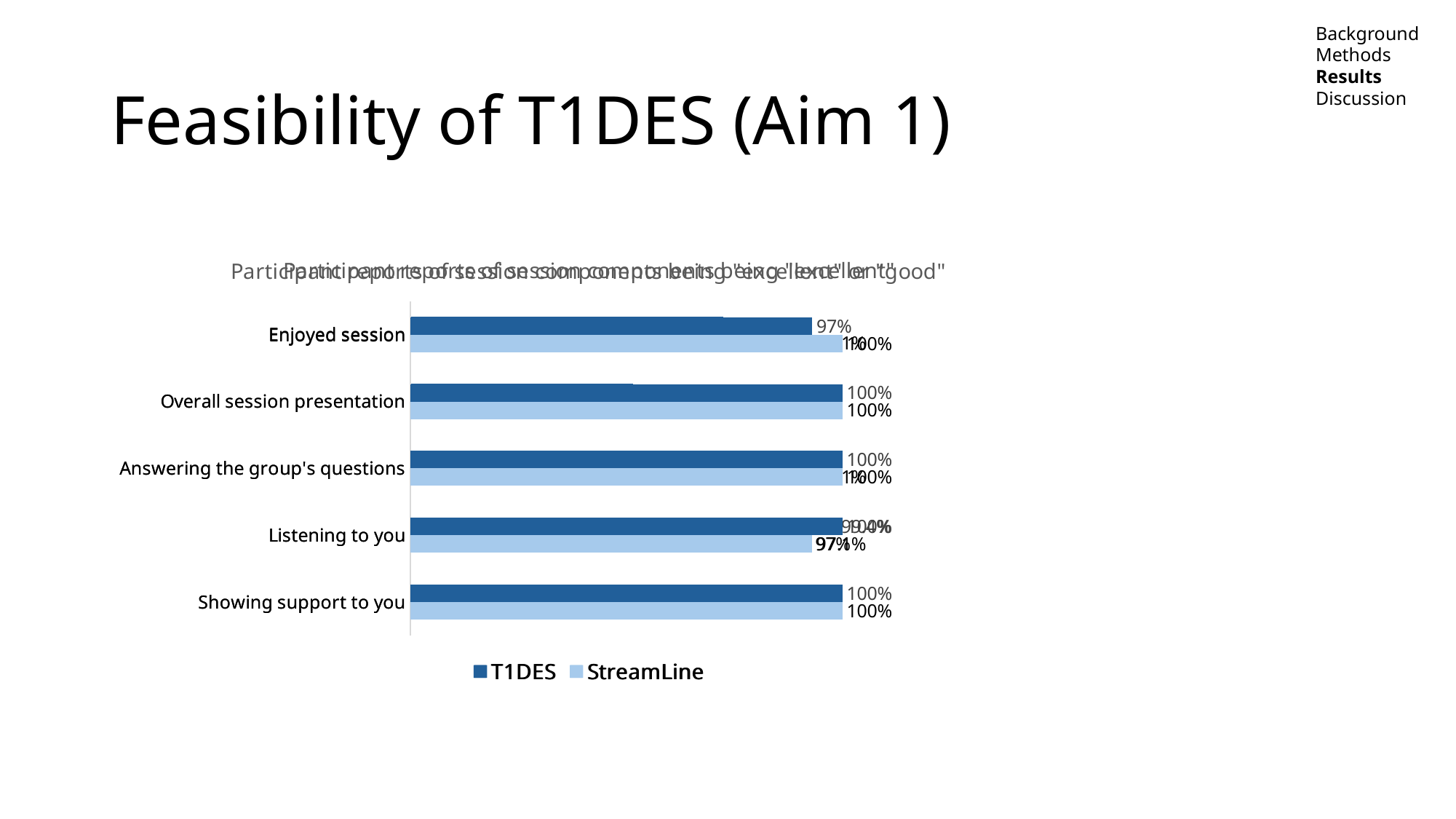
Which category has the lowest T1DES value? Enjoyed session What is the difference between the T1DES and StreamLine values for Overall session presentation? 0% How many categories are shown on the chart? 5 What is the StreamLine value for Overall session presentation? 100% For Listening to you, which series has the larger value, T1DES or StreamLine? T1DES What is the T1DES value for Showing support to you? 100% What is the StreamLine value for Showing support to you? 100% What is the T1DES value for Answering the group's questions? 100% What is the T1DES value for Enjoyed session? 97% What is the T1DES value for Overall session presentation? 100% How many series does the legend list? 2 For Enjoyed session, which series has the larger value, T1DES or StreamLine? StreamLine